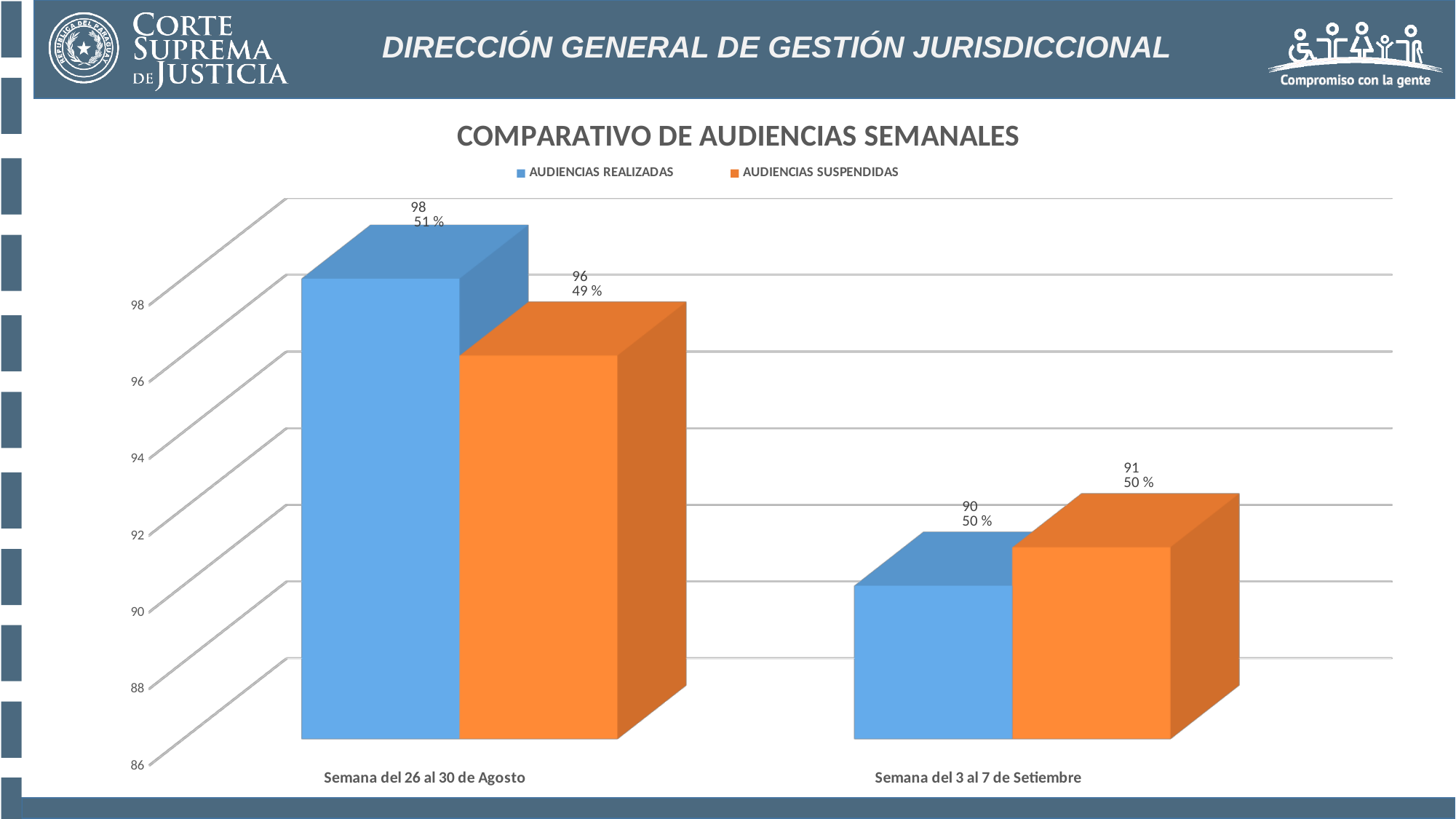
What is the value of AUDIENCIAS REALIZADAS for Semana del 26 al 30 de Agosto? 98 What is the difference between AUDIENCIAS REALIZADAS and AUDIENCIAS SUSPENDIDAS for Semana del 26 al 30 de Agosto? 2 What type of chart is shown on the slide? Bar chart What is the value of AUDIENCIAS SUSPENDIDAS for Semana del 3 al 7 de Setiembre? 91 How many categories are shown on the x axis? 2 Which week has the lower value for AUDIENCIAS SUSPENDIDAS? Semana del 3 al 7 de Setiembre What is the difference in AUDIENCIAS REALIZADAS between Semana del 26 al 30 de Agosto and Semana del 3 al 7 de Setiembre? 8 What is the value of AUDIENCIAS SUSPENDIDAS for Semana del 26 al 30 de Agosto? 96 How many series does the legend list? 2 Which week has the higher value for AUDIENCIAS REALIZADAS? Semana del 26 al 30 de Agosto What percentage is shown for AUDIENCIAS REALIZADAS in Semana del 26 al 30 de Agosto? 51 % What is the value of AUDIENCIAS REALIZADAS for Semana del 3 al 7 de Setiembre? 90